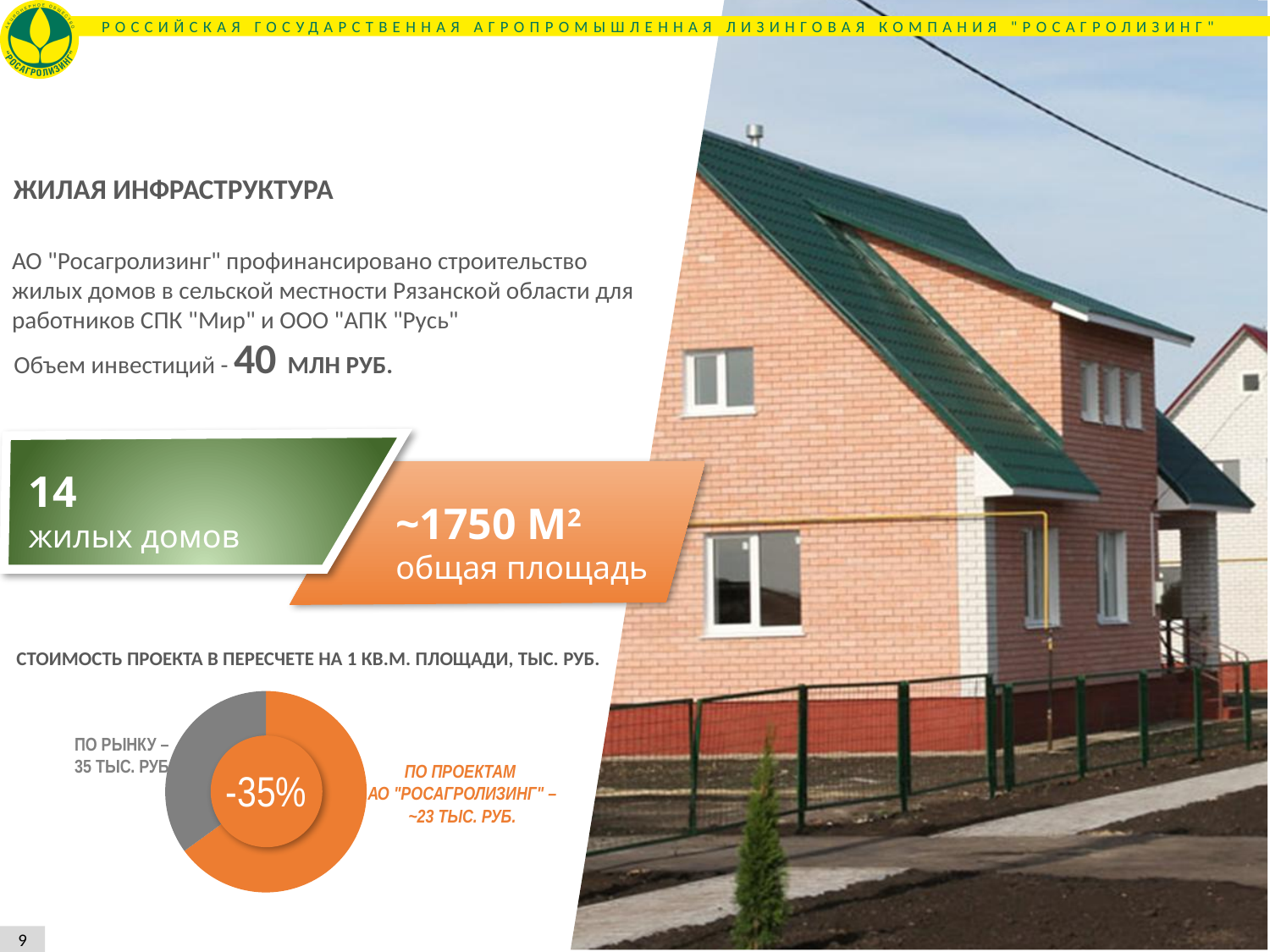
What kind of chart is shown at the bottom left of the slide? doughnut chart What colour is the segment labelled ПО РЫНКУ in the pie chart? grey In the pie chart, what is the project cost per 1 sq.m. by market (ПО РЫНКУ), in thousand rubles? 35 According to the pie chart labels, which cost per 1 sq.m. is higher: by market (ПО РЫНКУ) or by AO "Росагролизинг" projects? ПО РЫНКУ How many segments does the pie chart at the bottom left of the slide have? 2 What is the title of the pie chart at the bottom left of the slide? СТОИМОСТЬ ПРОЕКТА В ПЕРЕСЧЕТЕ НА 1 КВ.М. ПЛОЩАДИ, ТЫС. РУБ.